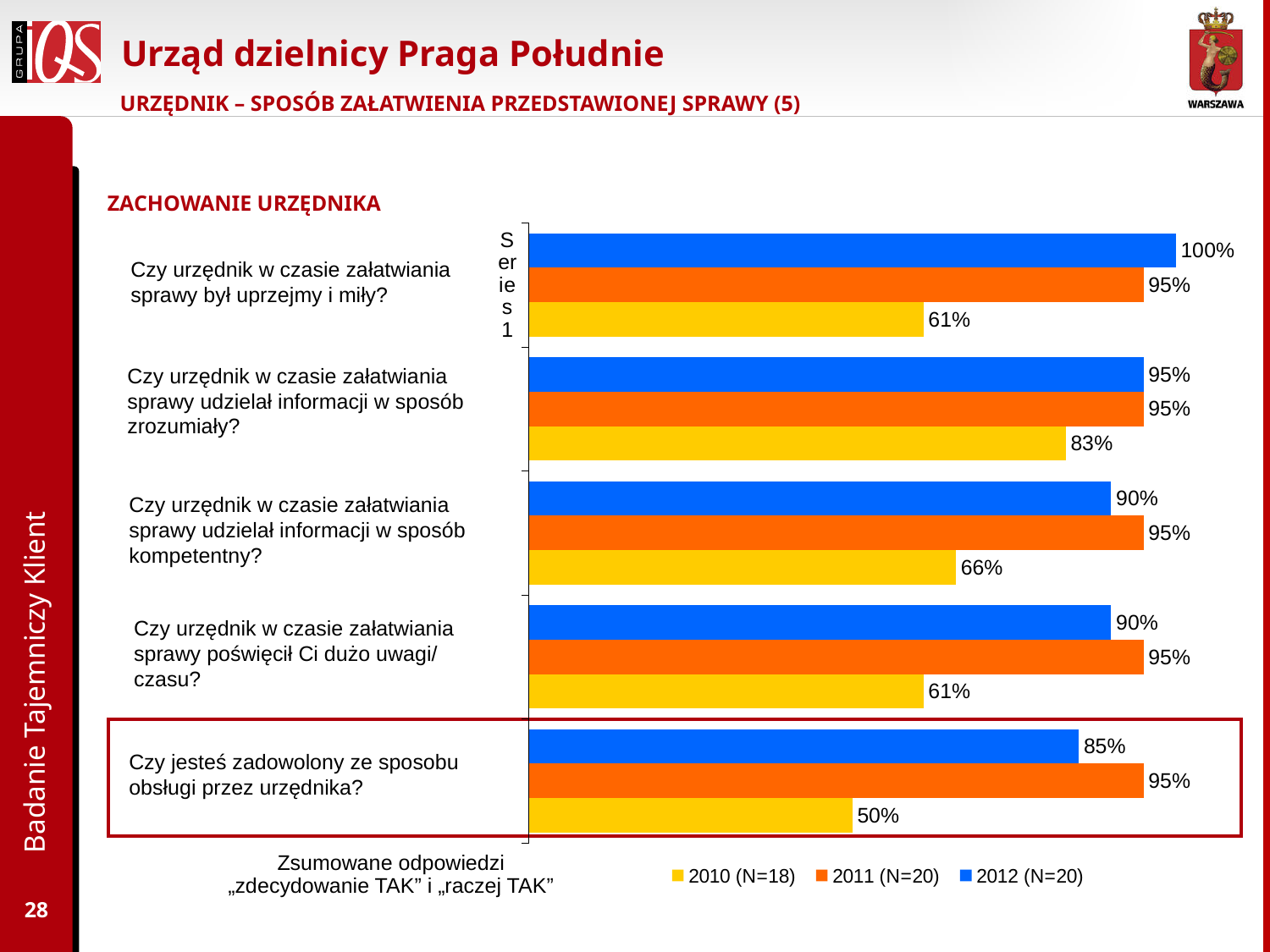
What sample size (N) does the legend give for 2010? N=18 What is the 2012 value for "Czy urzędnik w czasie załatwiania sprawy był uprzejmy i miły?"? 100% What is the 2010 value for "Czy urzędnik w czasie załatwiania sprawy udzielał informacji w sposób zrozumiały?"? 83% What is the difference between the 2012 and 2010 values for "Czy urzędnik w czasie załatwiania sprawy poświęcił Ci dużo uwagi/czasu?"? 29% What is the 2012 value for "Czy urzędnik w czasie załatwiania sprawy udzielał informacji w sposób kompetentny?"? 90% For "Czy jesteś zadowolony ze sposobu obsługi przez urzędnika?", which is larger: the 2011 value or the 2012 value? 2011 How many question categories are plotted in the chart? 5 What type of chart is shown on the slide? bar chart What is the 2010 value for "Czy jesteś zadowolony ze sposobu obsługi przez urzędnika?"? 50% Which question has the highest 2012 value? Czy urzędnik w czasie załatwiania sprawy był uprzejmy i miły? How many series does the legend list? 3 Which question has the lowest 2010 value? Czy jesteś zadowolony ze sposobu obsługi przez urzędnika?